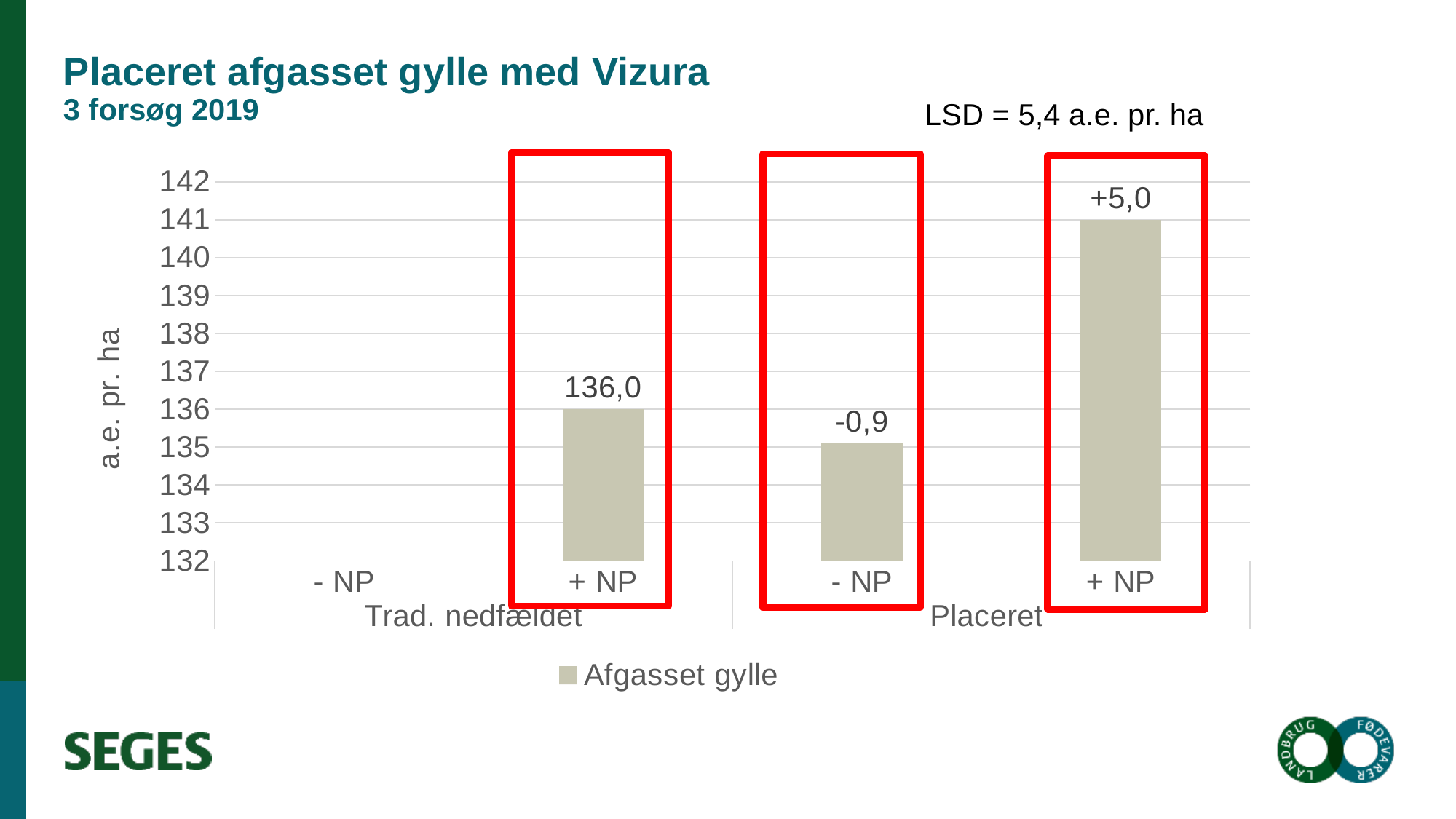
How many bars are plotted in the chart? 3 Is the value for - NP under Placeret greater or less than 136? less What is the data label on the + NP bar under Placeret? +5,0 Which bar is the tallest in the chart? + NP under Placeret What is the data label on the - NP bar under Placeret? -0,9 What kind of chart is shown on the slide? bar chart How many series does the legend list? 1 What is the legend entry of the chart? Afgasset gylle What is the data label on the + NP bar under Trad. nedfældet? 136,0 Is the value for + NP under Placeret greater or less than 140? greater Which bar is the shortest in the chart? - NP under Placeret Which bar is taller: + NP under Trad. nedfældet or + NP under Placeret? + NP under Placeret